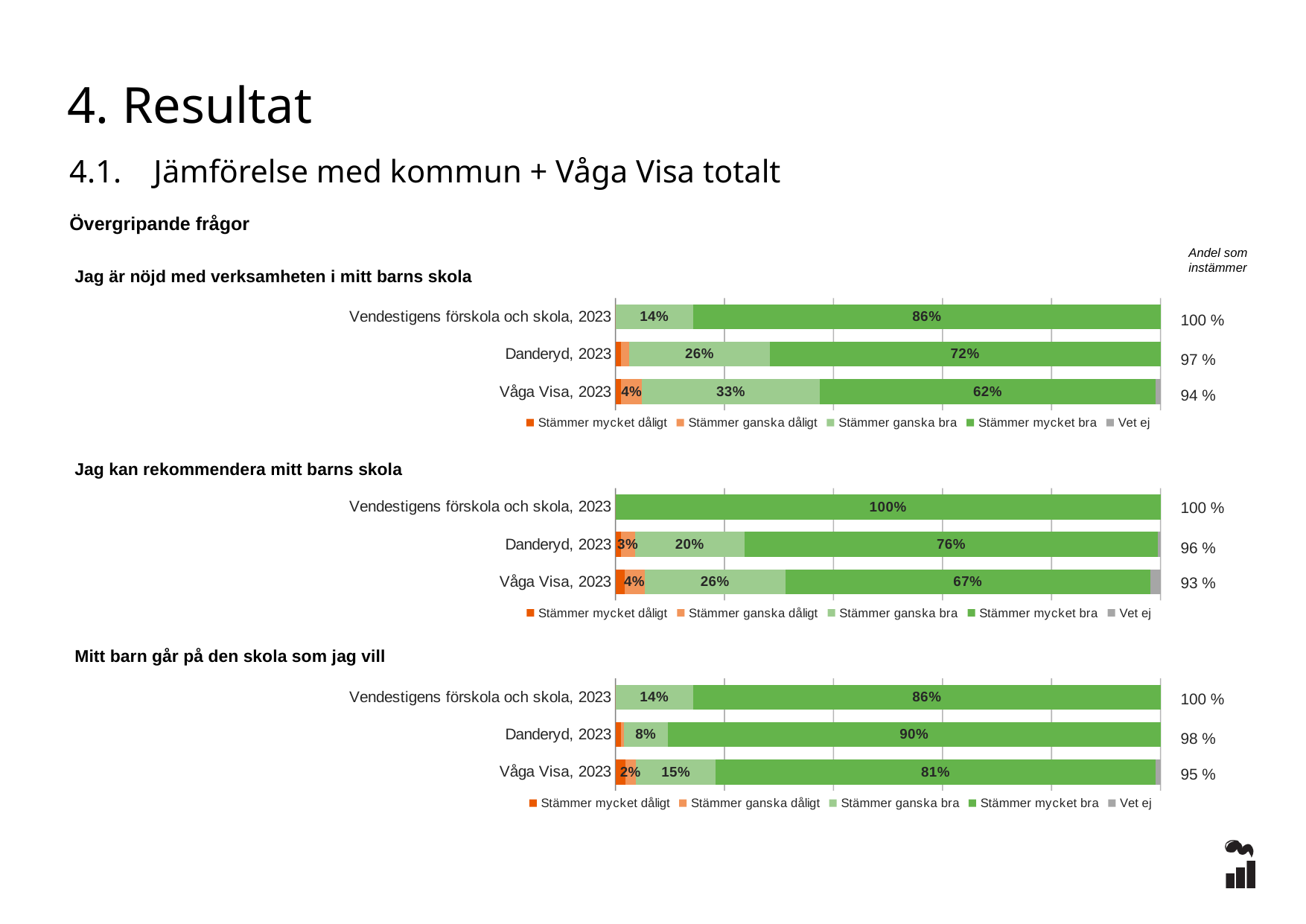
What kind of chart is "Mitt barn går på den skola som jag vill"? Stacked bar chart In the chart "Jag är nöjd med verksamheten i mitt barns skola", what is the "Stämmer ganska bra" value for Våga Visa, 2023? 33% In the chart "Mitt barn går på den skola som jag vill", what is the "Stämmer ganska bra" value for Våga Visa, 2023? 15% In the chart "Jag kan rekommendera mitt barns skola", what is the "Stämmer mycket bra" value for Vendestigens förskola och skola, 2023? 100% In the chart "Jag är nöjd med verksamheten i mitt barns skola", which category has the highest "Stämmer mycket bra" value? Vendestigens förskola och skola, 2023 In the chart "Mitt barn går på den skola som jag vill", which category has the lowest "Stämmer mycket bra" value? Våga Visa, 2023 In the chart "Jag kan rekommendera mitt barns skola", which has the larger "Stämmer mycket bra" value, Danderyd, 2023 or Våga Visa, 2023? Danderyd, 2023 In the chart "Jag kan rekommendera mitt barns skola", what is the "Stämmer ganska bra" value for Danderyd, 2023? 20% In the chart "Jag är nöjd med verksamheten i mitt barns skola", what is the "Stämmer mycket bra" value for Vendestigens förskola och skola, 2023? 86% In the chart "Mitt barn går på den skola som jag vill", what is the "Stämmer mycket bra" value for Danderyd, 2023? 90% In the chart "Jag är nöjd med verksamheten i mitt barns skola", what is the difference between the "Stämmer mycket bra" values for Danderyd, 2023 and Våga Visa, 2023? 10% How many series does the legend of the chart "Jag kan rekommendera mitt barns skola" list? 5